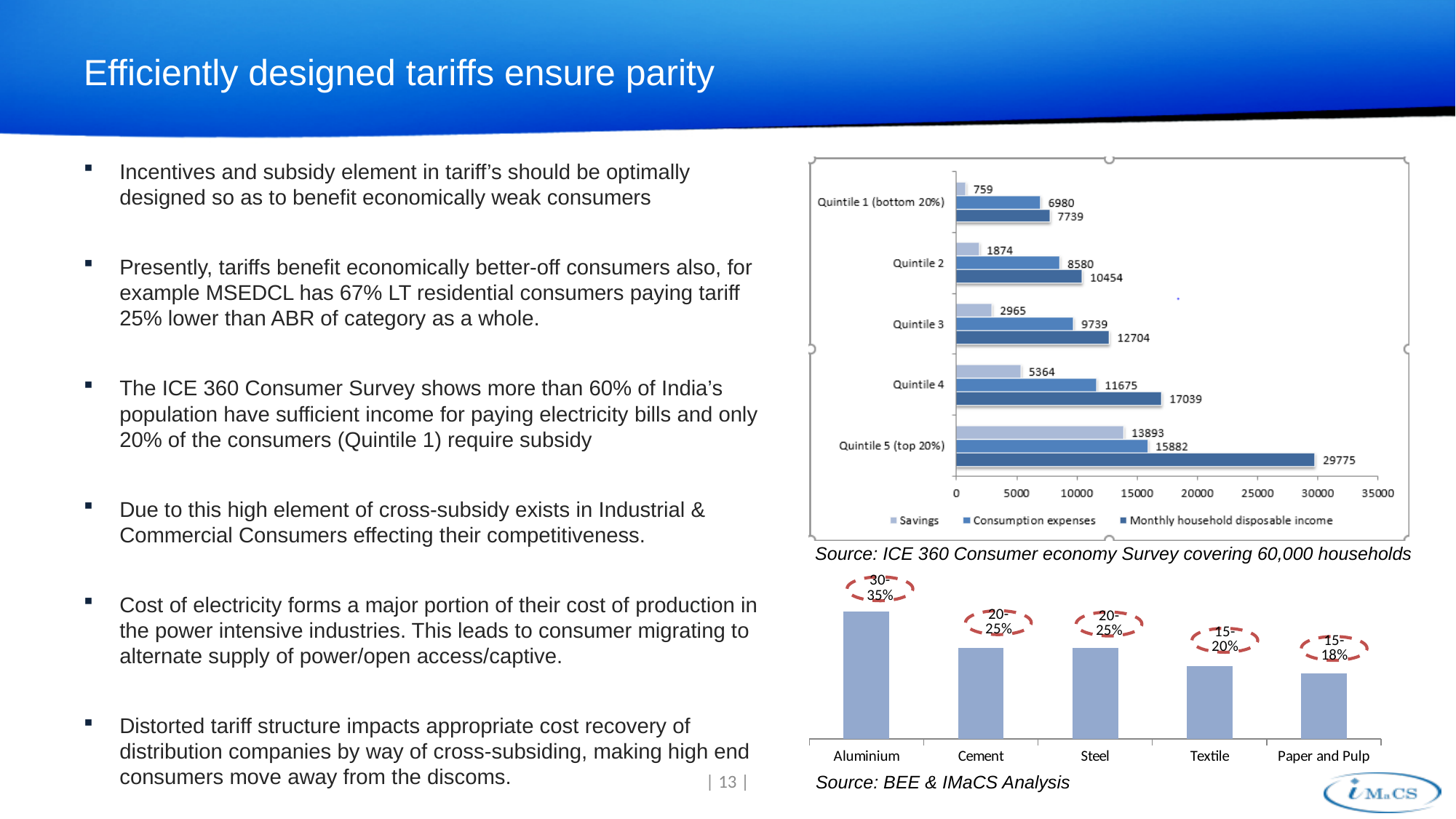
What kind of chart is the bottom-right chart showing Aluminium, Cement, Steel, Textile and Paper and Pulp? Bar chart How many quintile categories are shown in the top-right chart? 5 In the top-right quintile chart, what is the Monthly household disposable income for Quintile 5 (top 20%)? 29775 In the top-right quintile chart, what are the Consumption expenses for Quintile 3? 9739 In the top-right quintile chart, which is larger: Savings for Quintile 2 or Savings for Quintile 3? Savings for Quintile 3 In the top-right quintile chart, which quintile has the lowest Savings? Quintile 1 (bottom 20%) How many series does the legend of the top-right quintile chart list? 3 In the top-right quintile chart, what is the Savings value for Quintile 1 (bottom 20%)? 759 In the bottom-right industry chart, what percentage range is labelled for Aluminium? 30-35% In the top-right quintile chart, what is the difference between Monthly household disposable income and Consumption expenses for Quintile 4? 5364 In the bottom-right industry chart, do the bar heights rise or fall from Aluminium to Paper and Pulp? Fall In the top-right quintile chart, which quintile has the highest Monthly household disposable income? Quintile 5 (top 20%)